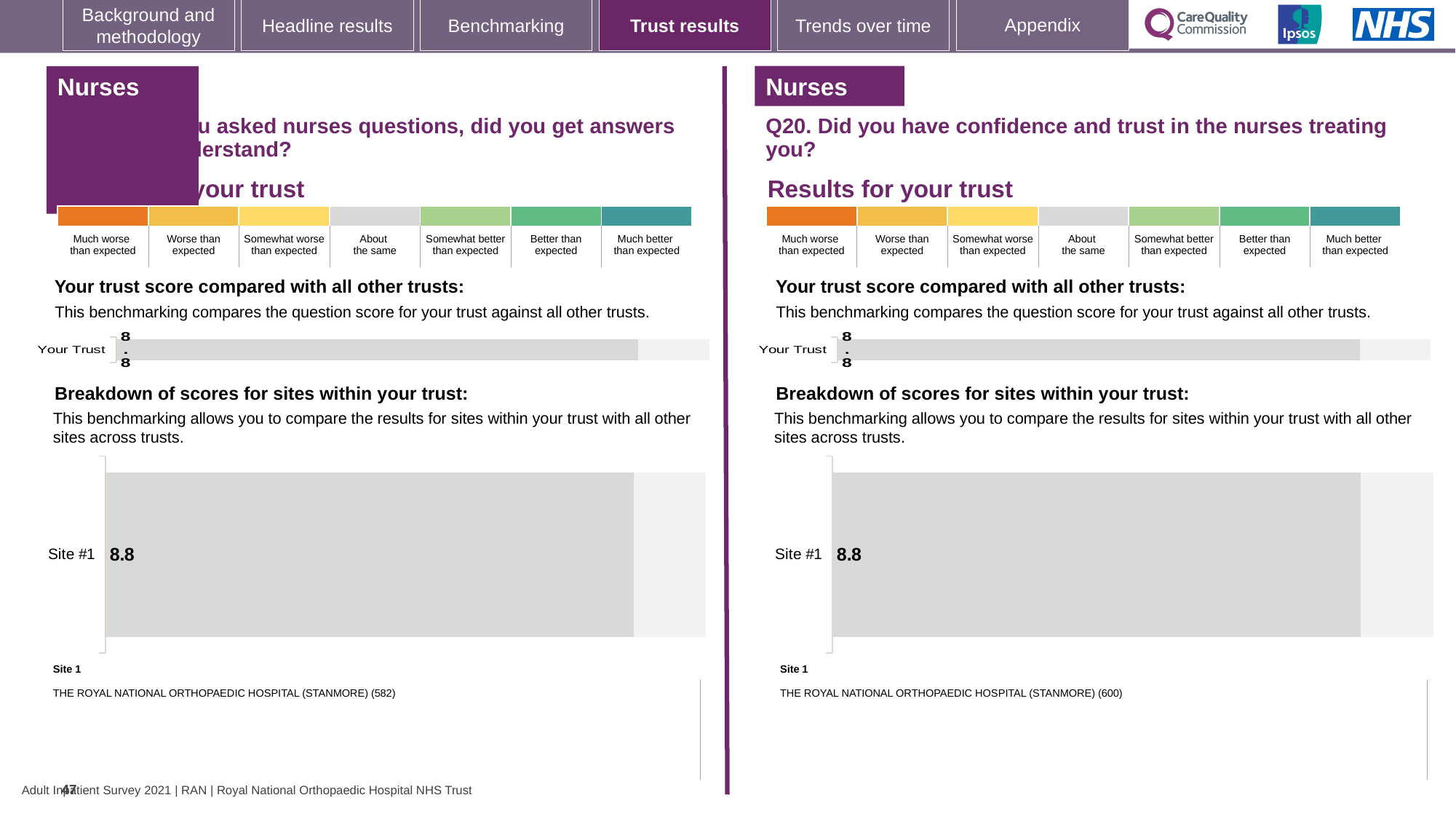
On the left half of the slide, what is the difference between the Site #1 score and the Your Trust score? 0.0 What is the name of the site labelled Site 1 on the right half of the slide? THE ROYAL NATIONAL ORTHOPAEDIC HOSPITAL (STANMORE) (600) How many sites are plotted in the 'Breakdown of scores for sites within your trust' chart on the left half of the slide? 1 On the left half of the slide, in the 'Breakdown of scores for sites within your trust' chart, what is the score shown for Site #1? 8.8 On the right half of the slide (Q20), in the 'Breakdown of scores for sites within your trust' chart, what is the score shown for Site #1? 8.8 On the right half of the slide, is the Site #1 score greater or less than the Your Trust score, or are they equal? equal How many categories does the colour scale above the charts list, from 'Much worse than expected' to 'Much better than expected'? 7 On the right half of the slide (Q20), in the 'Your trust score compared with all other trusts' chart, what is the value shown for Your Trust? 8.8 On the left half of the slide, in the 'Your trust score compared with all other trusts' chart, what is the value shown for Your Trust? 8.8 What kind of chart is used to show the Site #1 score on the right half of the slide? bar chart How many sites are plotted in the 'Breakdown of scores for sites within your trust' chart on the right half of the slide? 1